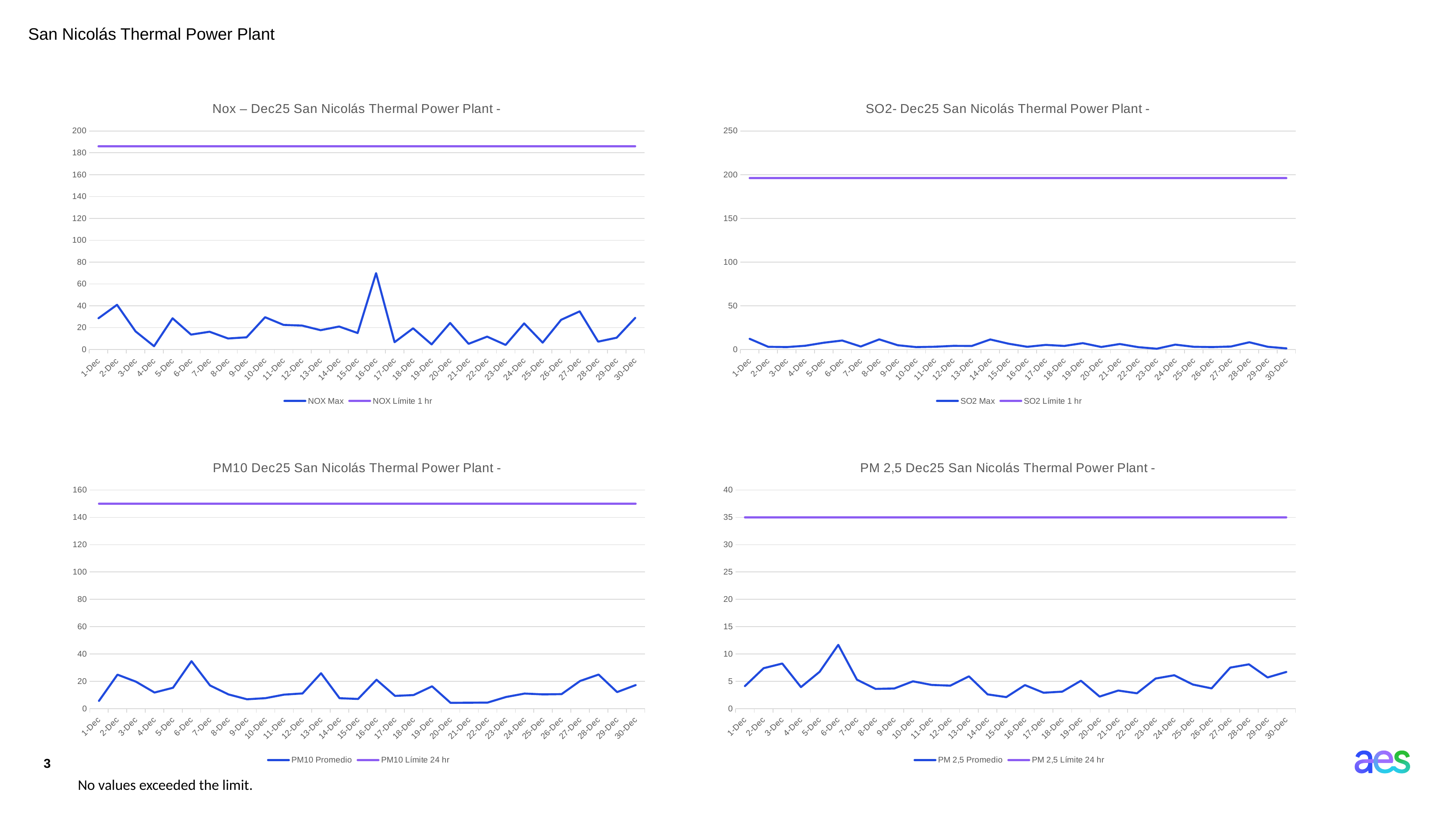
How many dates are plotted along the x axis of the 'PM10 Dec25 San Nicolás Thermal Power Plant' chart? 30 What are the two legend entries of the 'Nox – Dec25 San Nicolás Thermal Power Plant' chart? NOX Max and NOX Límite 1 hr In the 'SO2- Dec25 San Nicolás Thermal Power Plant' chart, is the SO2 Max value on 1-Dec greater or less than 50? less In the 'PM 2,5 Dec25 San Nicolás Thermal Power Plant' chart, what is the value of the PM 2,5 Límite 24 hr line? 35 In the 'PM 2,5 Dec25 San Nicolás Thermal Power Plant' chart, which is larger: the PM 2,5 Promedio value on 6-Dec or on 15-Dec? 6-Dec In the 'Nox – Dec25 San Nicolás Thermal Power Plant' chart, is the NOX Max value on 16-Dec greater or less than 60? greater In the 'Nox – Dec25 San Nicolás Thermal Power Plant' chart, on which date does NOX Max reach its highest value? 16-Dec How many series does the legend of the 'SO2- Dec25 San Nicolás Thermal Power Plant' chart list? 2 What kind of chart is the 'Nox – Dec25 San Nicolás Thermal Power Plant' chart? line chart In the 'PM 2,5 Dec25 San Nicolás Thermal Power Plant' chart, on which date does PM 2,5 Promedio reach its highest value? 6-Dec In the 'PM10 Dec25 San Nicolás Thermal Power Plant' chart, on which date does PM10 Promedio reach its highest value? 6-Dec In the 'PM10 Dec25 San Nicolás Thermal Power Plant' chart, is the PM10 Límite 24 hr value greater or less than 140? greater